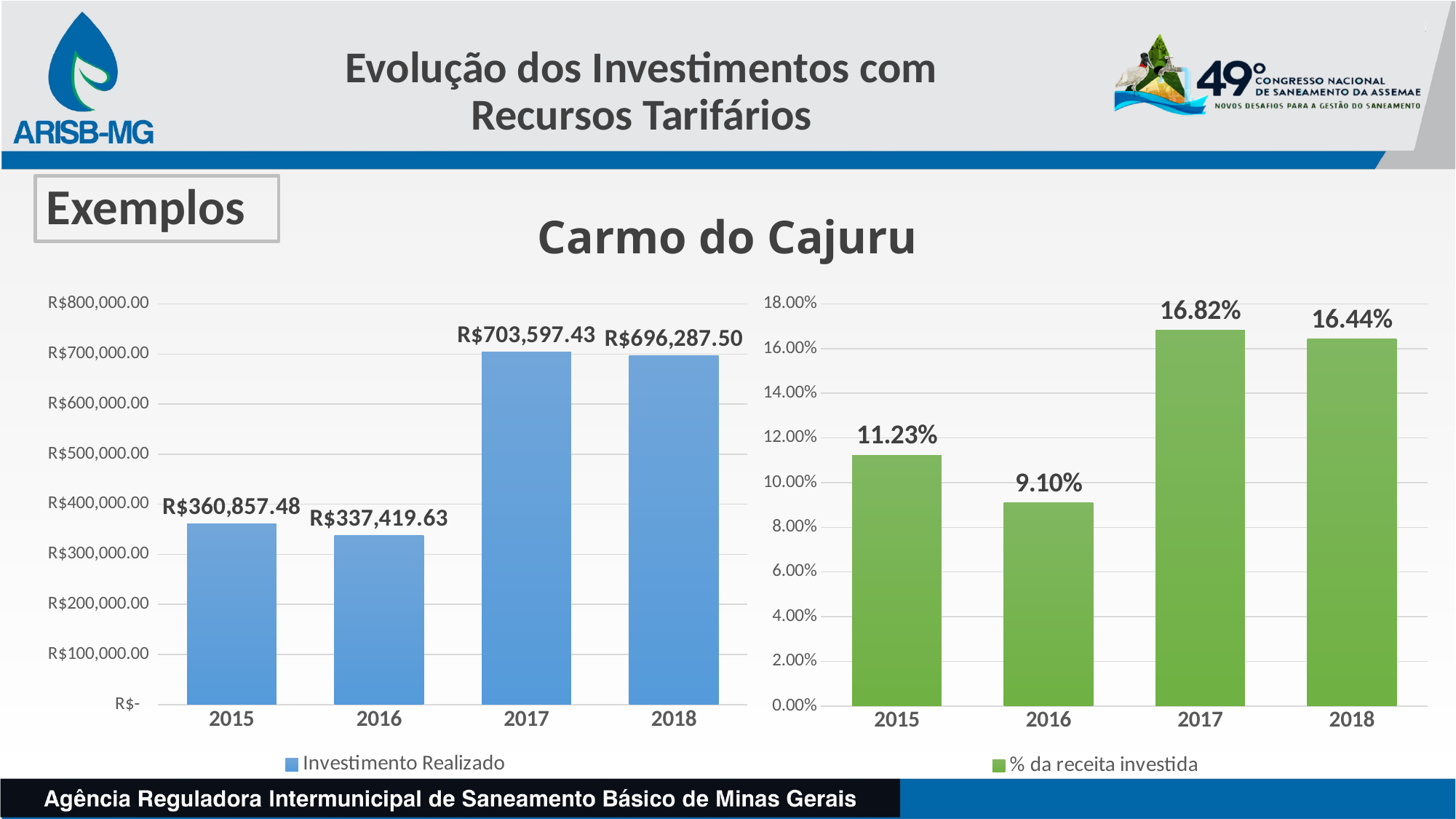
In the right chart (% da receita investida), what is the value for 2018? 16.44% In the left chart (Investimento Realizado), what is the value for 2017? R$703,597.43 What is the legend entry of the right chart? % da receita investida What kind of chart is the left chart (Investimento Realizado)? Bar chart In the left chart (Investimento Realizado), which year has the lowest value? 2016 In the right chart (% da receita investida), what is the value for 2015? 11.23% In the right chart (% da receita investida), which year has the highest value? 2017 How many years are shown on the x axis of the right chart (% da receita investida)? 4 In the right chart (% da receita investida), what is the difference between the 2017 and 2016 values? 7.72% In the left chart (Investimento Realizado), what is the value for 2016? R$337,419.63 In the left chart (Investimento Realizado), what is the difference between the 2017 and 2018 values? R$7,309.93 In the left chart (Investimento Realizado), which is larger: the value for 2015 or the value for 2016? 2015